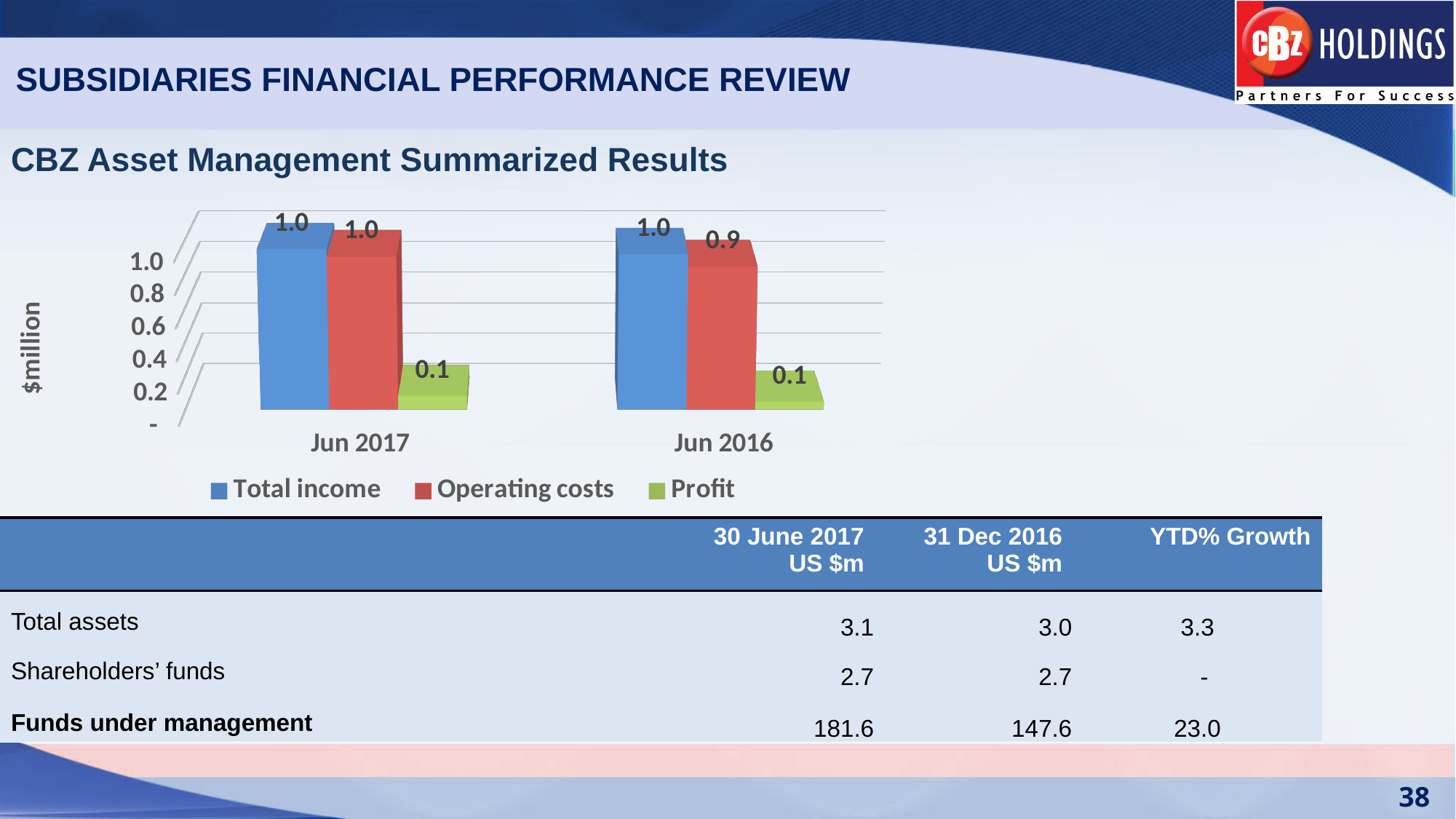
What is the Total income for Jun 2017? 1.0 What are the Operating costs for Jun 2017? 1.0 What is the difference between Total income and Profit for Jun 2017? 0.9 What kind of chart is shown on the slide? Bar chart How many periods are shown on the x axis of the chart? 2 Which series has the lowest value for Jun 2016? Profit What are the Operating costs for Jun 2016? 0.9 How many series does the chart legend list? 3 What is the Profit for Jun 2017? 0.1 By how much did Operating costs change from Jun 2016 to Jun 2017? 0.1 What is the label on the vertical axis of the chart? $million Were Operating costs higher in Jun 2017 or Jun 2016? Jun 2017